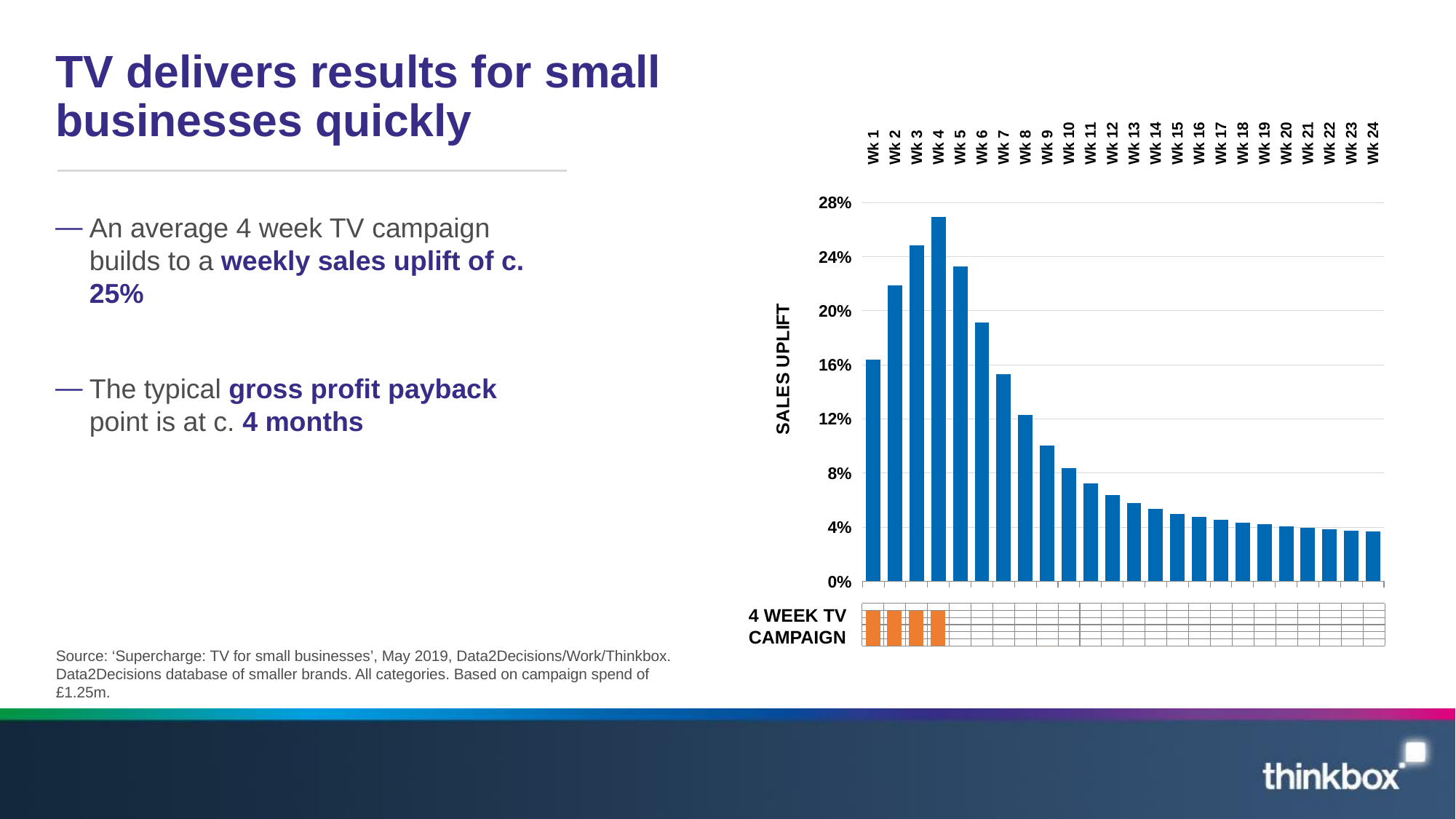
How many weeks are plotted on the x axis of the chart? 24 Which has a higher sales uplift, Wk 2 or Wk 7? Wk 2 What kind of chart is shown on the slide? bar chart Do the sales uplift values rise or fall from Wk 4 to Wk 24? fall Which has a higher sales uplift, Wk 3 or Wk 5? Wk 3 Which week has the highest sales uplift? Wk 4 Is the sales uplift for Wk 4 greater or less than 24%? greater Is the sales uplift for Wk 9 greater or less than 8%? greater Is the sales uplift for Wk 8 greater or less than 16%? less What is the label on the vertical axis of the chart? SALES UPLIFT